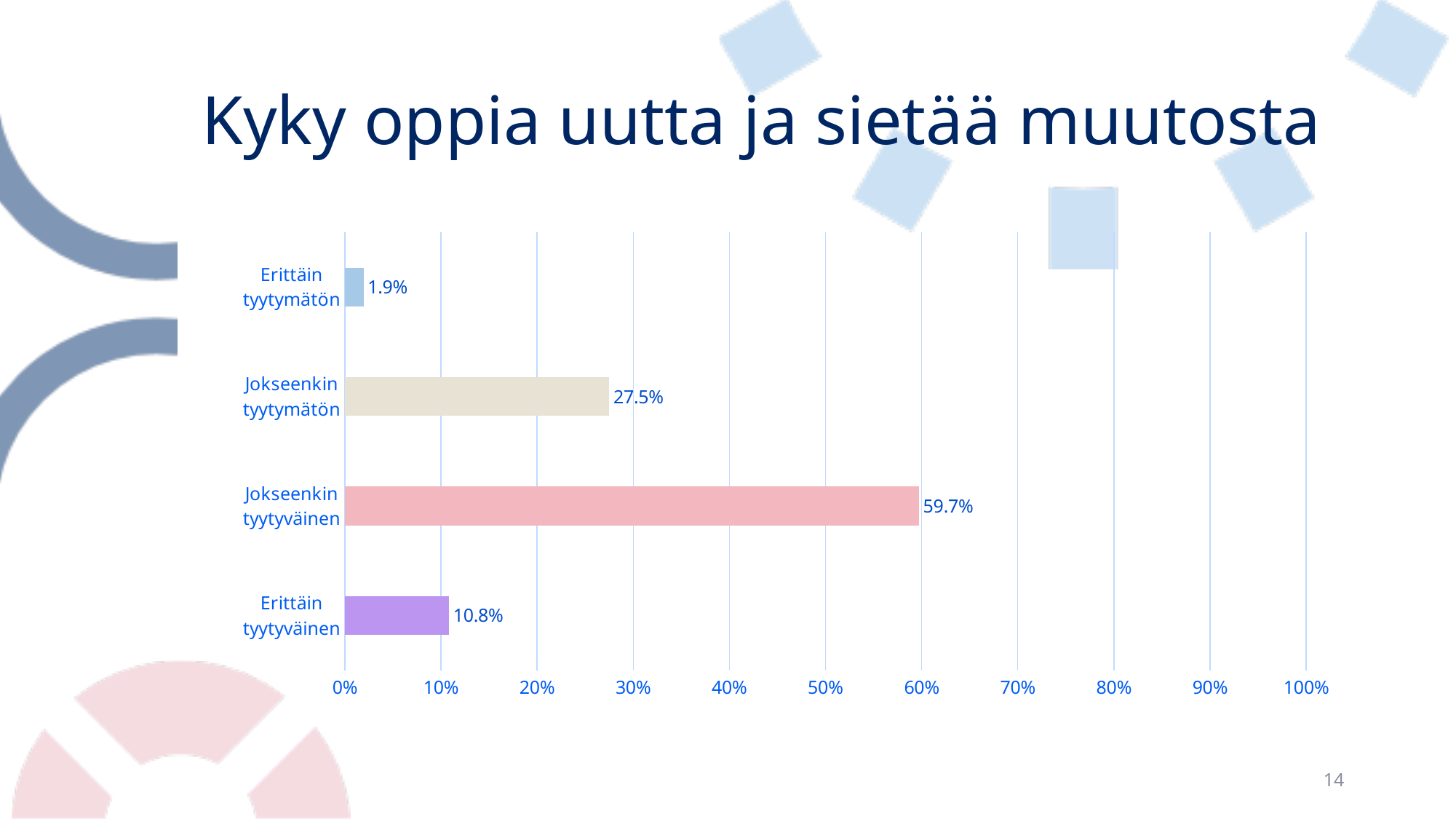
Is the value for Jokseenkin tyytyväinen greater or less than 50%? greater What is the value for Jokseenkin tyytyväinen? 59.7% How many categories are shown in the chart? 4 Which category has the highest value? Jokseenkin tyytyväinen What is the value for Erittäin tyytyväinen? 10.8% Which category has the lowest value? Erittäin tyytymätön What is the value for Erittäin tyytymätön? 1.9% What kind of chart is shown on the slide? bar chart Which is larger, the value for Erittäin tyytyväinen or the value for Jokseenkin tyytymätön? Jokseenkin tyytymätön What is the title of the slide? Kyky oppia uutta ja sietää muutosta What is the difference between the values for Jokseenkin tyytyväinen and Jokseenkin tyytymätön? 32.2% What is the value for Jokseenkin tyytymätön? 27.5%